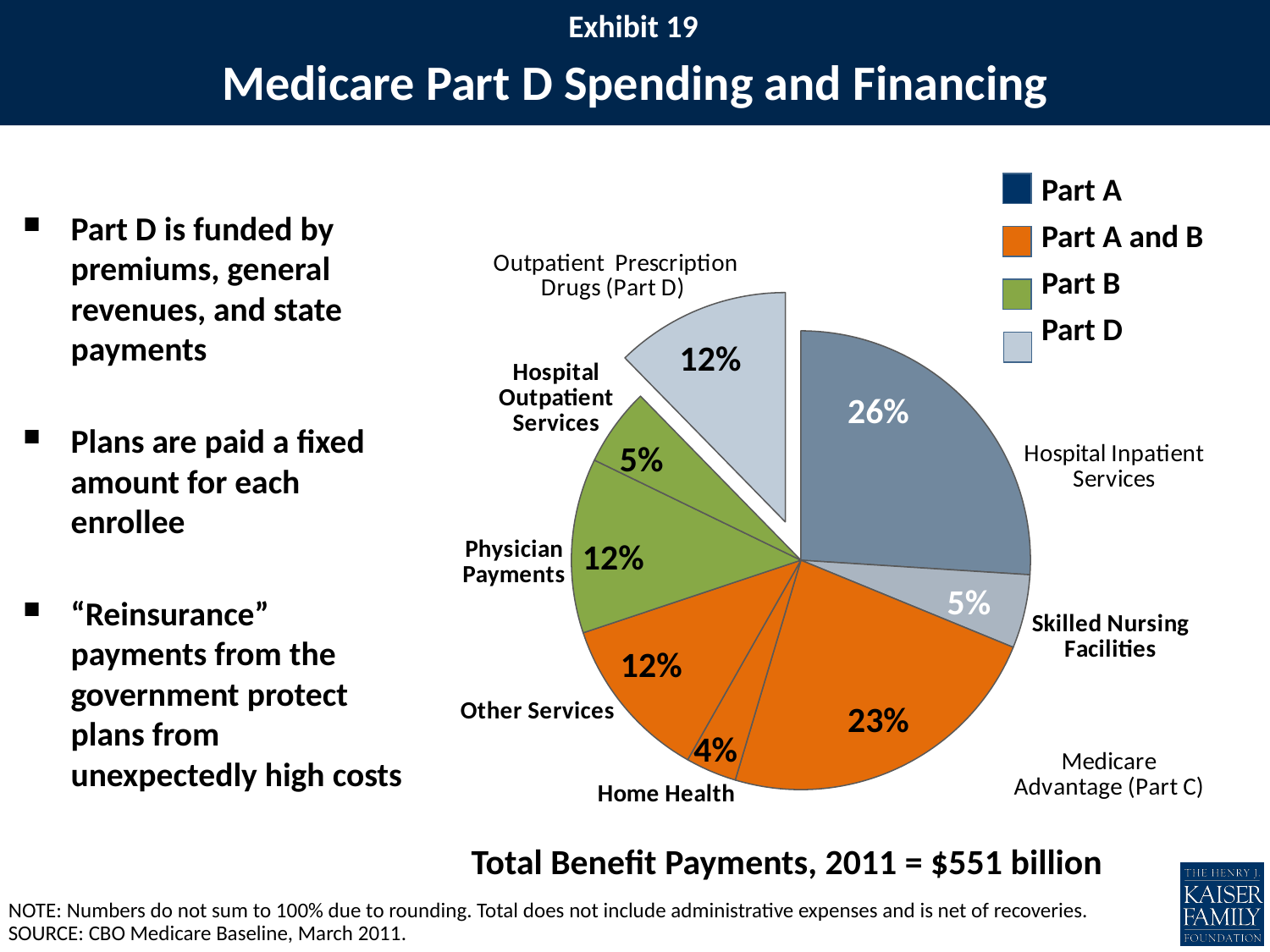
What kind of chart is shown on the slide? pie chart Which category has the smallest slice of the pie? Home Health Which category has the largest slice of the pie? Hospital Inpatient Services What share of total benefit payments goes to Hospital Inpatient Services? 26% What total benefit payments figure for 2011 is stated below the chart? $551 billion What percentage of the pie is Medicare Advantage (Part C)? 23% Which is larger, the slice for Medicare Advantage (Part C) or the slice for Other Services? Medicare Advantage (Part C) What is the difference in percentage points between Hospital Inpatient Services and Medicare Advantage (Part C)? 3 percentage points What percentage is shown for Skilled Nursing Facilities? 5% How many entries does the legend list? 4 What share does Outpatient Prescription Drugs (Part D) represent? 12% What is the value shown for Home Health? 4%